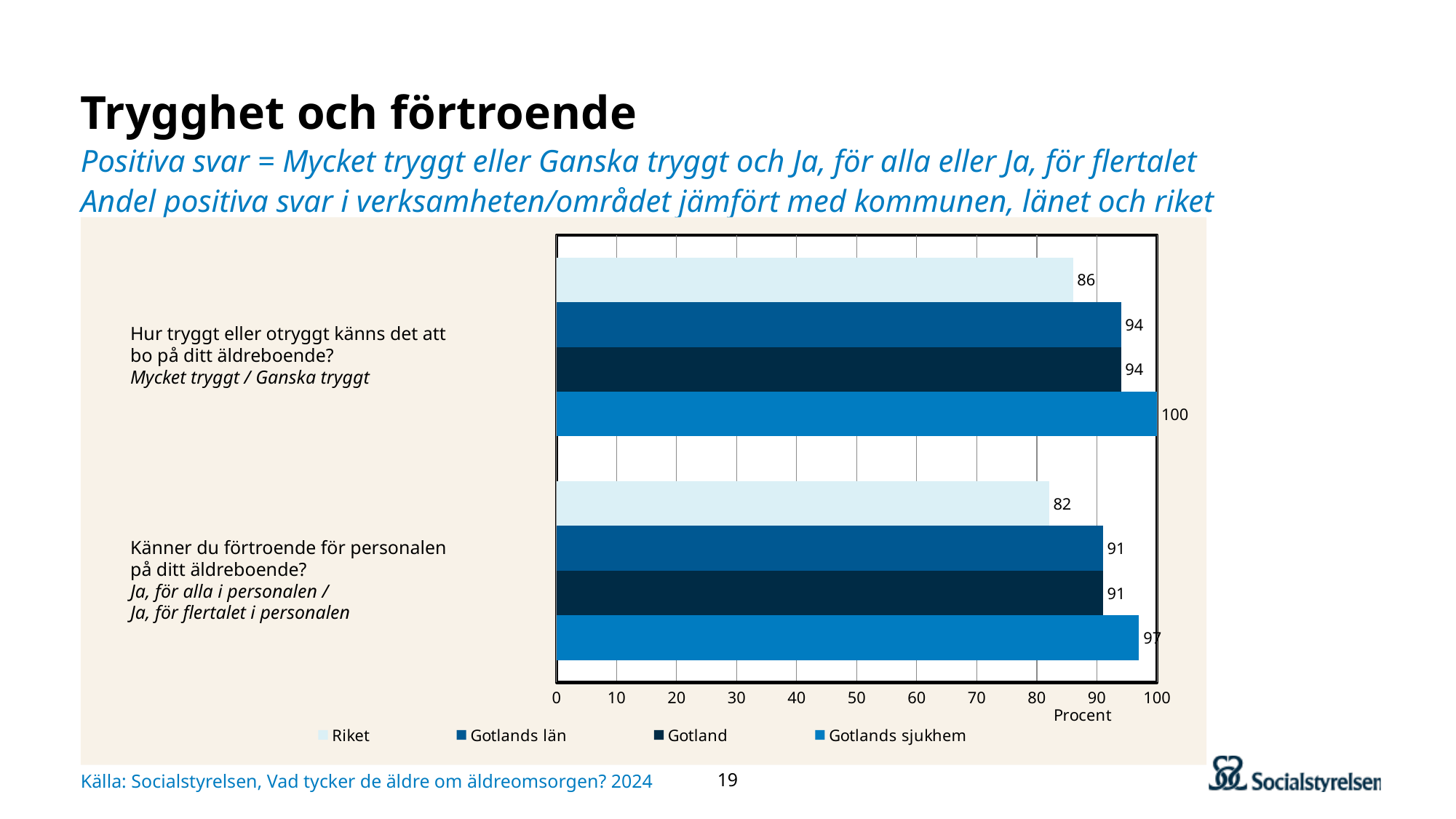
What is the difference between Gotlands sjukhem and Gotland on the question "Känner du förtroende för personalen på ditt äldreboende?"? 6 What is the value for Riket on the question "Känner du förtroende för personalen på ditt äldreboende?"? 82 How many series does the legend list? 4 Which is larger: the Riket value for the trygghet question or the Riket value for the förtroende question? the trygghet question (86) How many question categories are shown on the chart? 2 What is the value for Gotland on the question "Känner du förtroende för personalen på ditt äldreboende?"? 91 What is the value for Gotlands län on the question "Hur tryggt eller otryggt känns det att bo på ditt äldreboende?"? 94 What is the value for Gotlands sjukhem on the question "Hur tryggt eller otryggt känns det att bo på ditt äldreboende?"? 100 Which series has the highest value on the question "Känner du förtroende för personalen på ditt äldreboende?"? Gotlands sjukhem What kind of chart is shown on the slide? bar chart Which series has the lowest value on the question "Hur tryggt eller otryggt känns det att bo på ditt äldreboende?"? Riket What is the difference between Gotlands sjukhem and Riket on the question "Hur tryggt eller otryggt känns det att bo på ditt äldreboende?"? 14